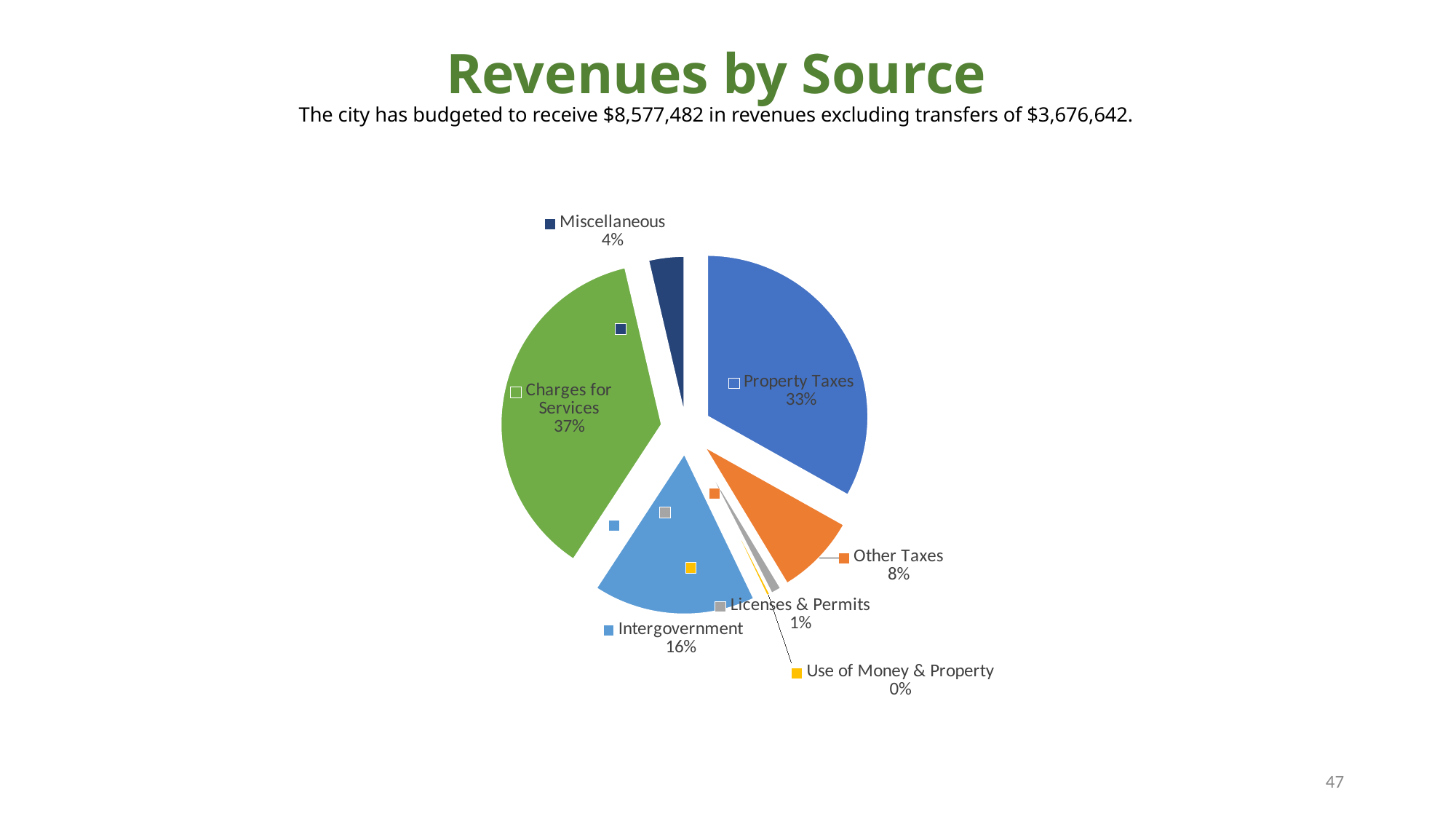
Which revenue source has the smallest share of the pie? Use of Money & Property How many percentage points larger is the Charges for Services share than the Property Taxes share? 4 How many revenue sources are shown in the pie chart? 7 What percentage of revenues is Miscellaneous? 4% What percentage of revenues is Licenses & Permits? 1% What percentage of revenues is Intergovernment? 16% Which revenue source has the largest share of the pie? Charges for Services What type of chart is shown on the slide? Pie chart What percentage of revenues is Other Taxes? 8% What share of revenues comes from Property Taxes? 33% What share of revenues comes from Charges for Services? 37% Which is larger, the Intergovernment share or the Other Taxes share? Intergovernment